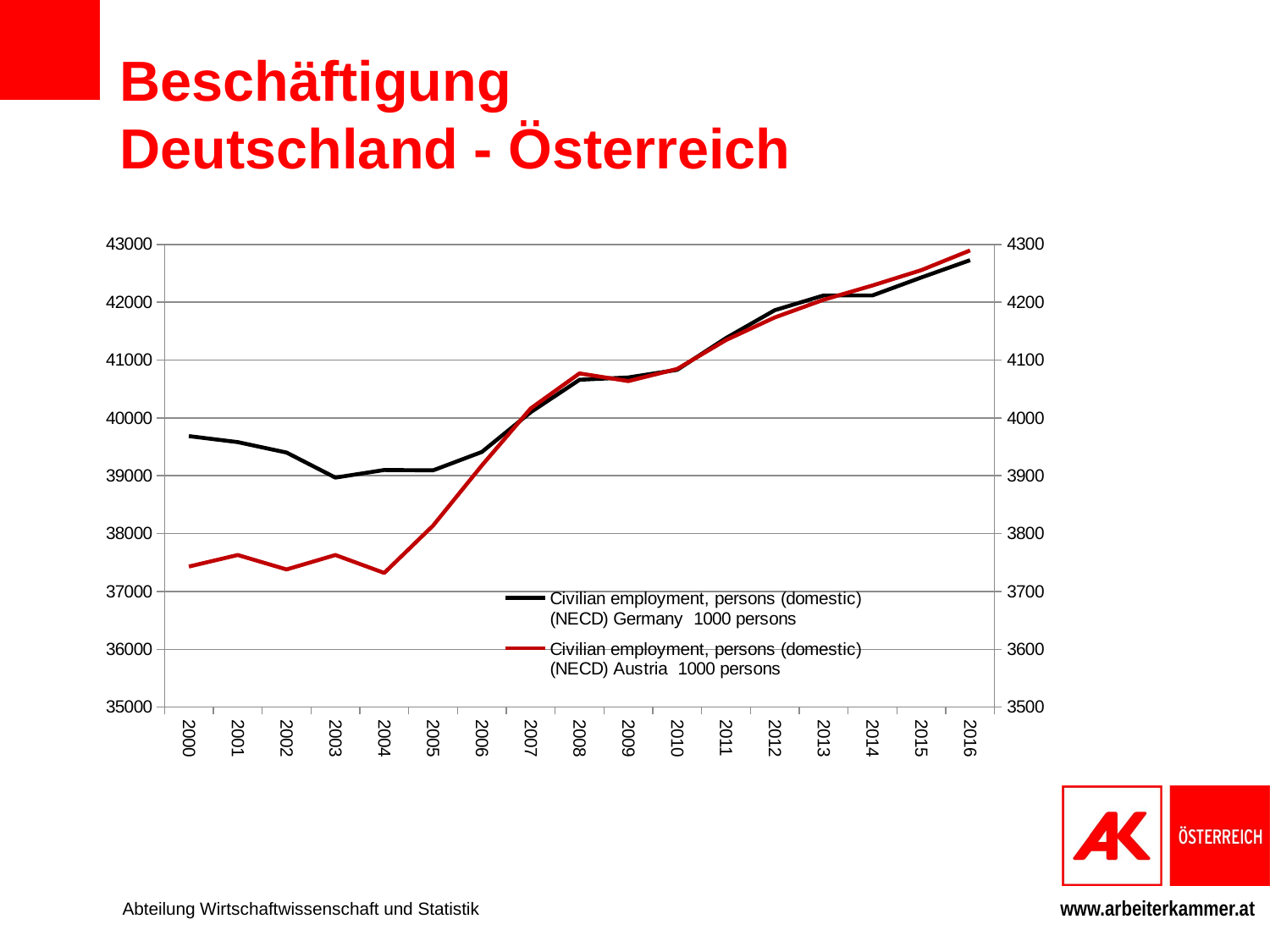
Does the Austria series rise or fall from 2004 to 2016? rise How many series does the legend list? 2 Which year has the highest value for the Germany series? 2016 Is the value for Germany in 2016 greater or less than 42000? greater Which year has the lowest value for the Germany series? 2003 Which year has the highest value for the Austria series? 2016 What colour is the line for the Austria series? red How many years are plotted along the x axis? 17 Is the value for Germany in 2000 greater or less than 39000? greater Is the value for Austria in 2004 greater or less than 3800? less What kind of chart is shown on the slide? line chart